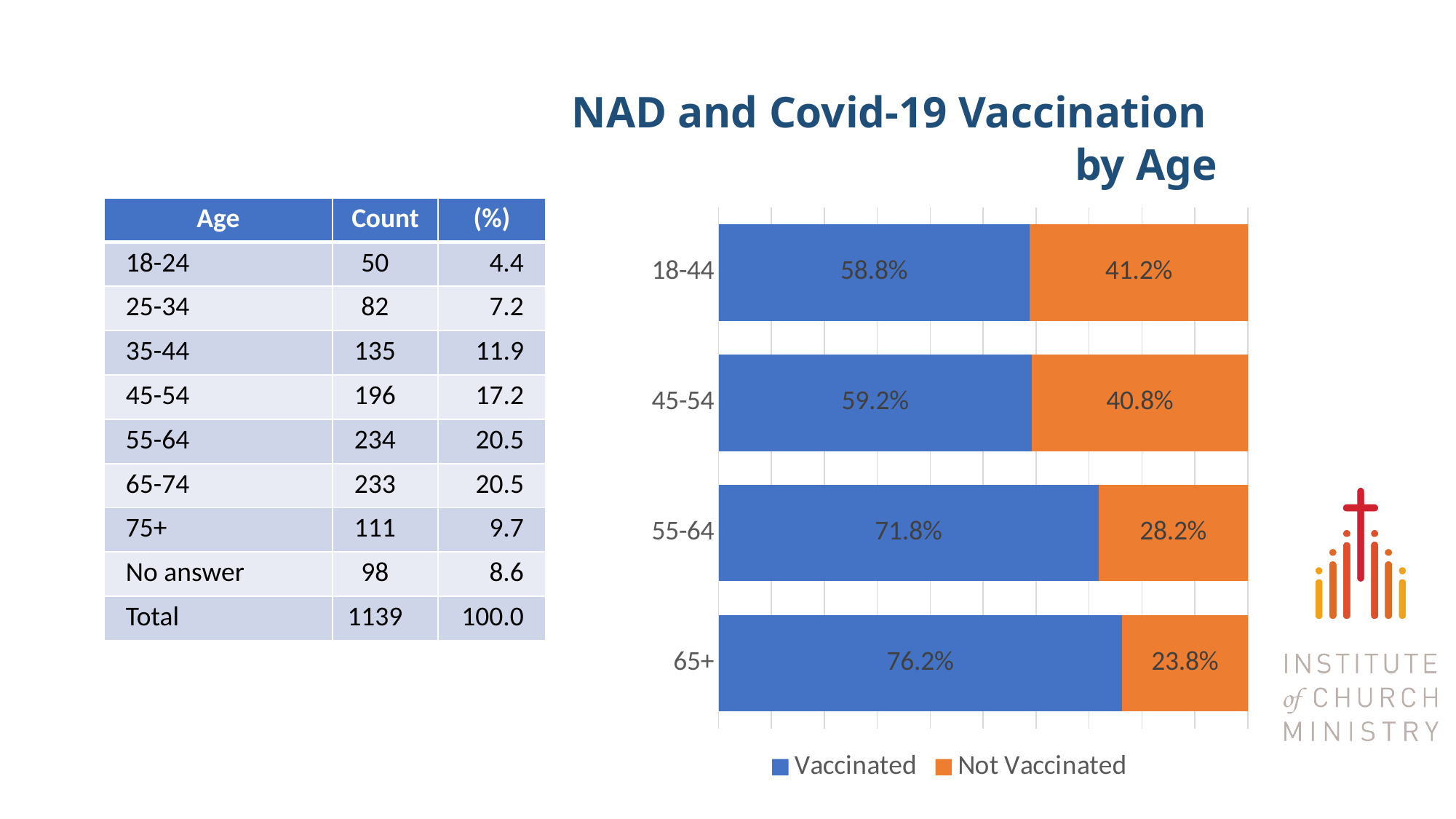
What is the title of the chart? NAD and Covid-19 Vaccination by Age Which age group has the highest Vaccinated percentage? 65+ What is the Not Vaccinated value for the 45-54 age group? 40.8% What percentage of the 18-44 age group is not vaccinated? 41.2% How many age groups are shown in the chart? 4 Which is larger: the Vaccinated percentage for 55-64 or for 45-54? 55-64 What type of chart is shown on the slide? Stacked bar chart What is the difference between the Vaccinated percentages for 65+ and 55-64? 4.4% What percentage of the 65+ age group is vaccinated? 76.2% What is the Vaccinated value for the 55-64 age group? 71.8% Which age group has the lowest Not Vaccinated percentage? 65+ How many series does the chart legend list? 2